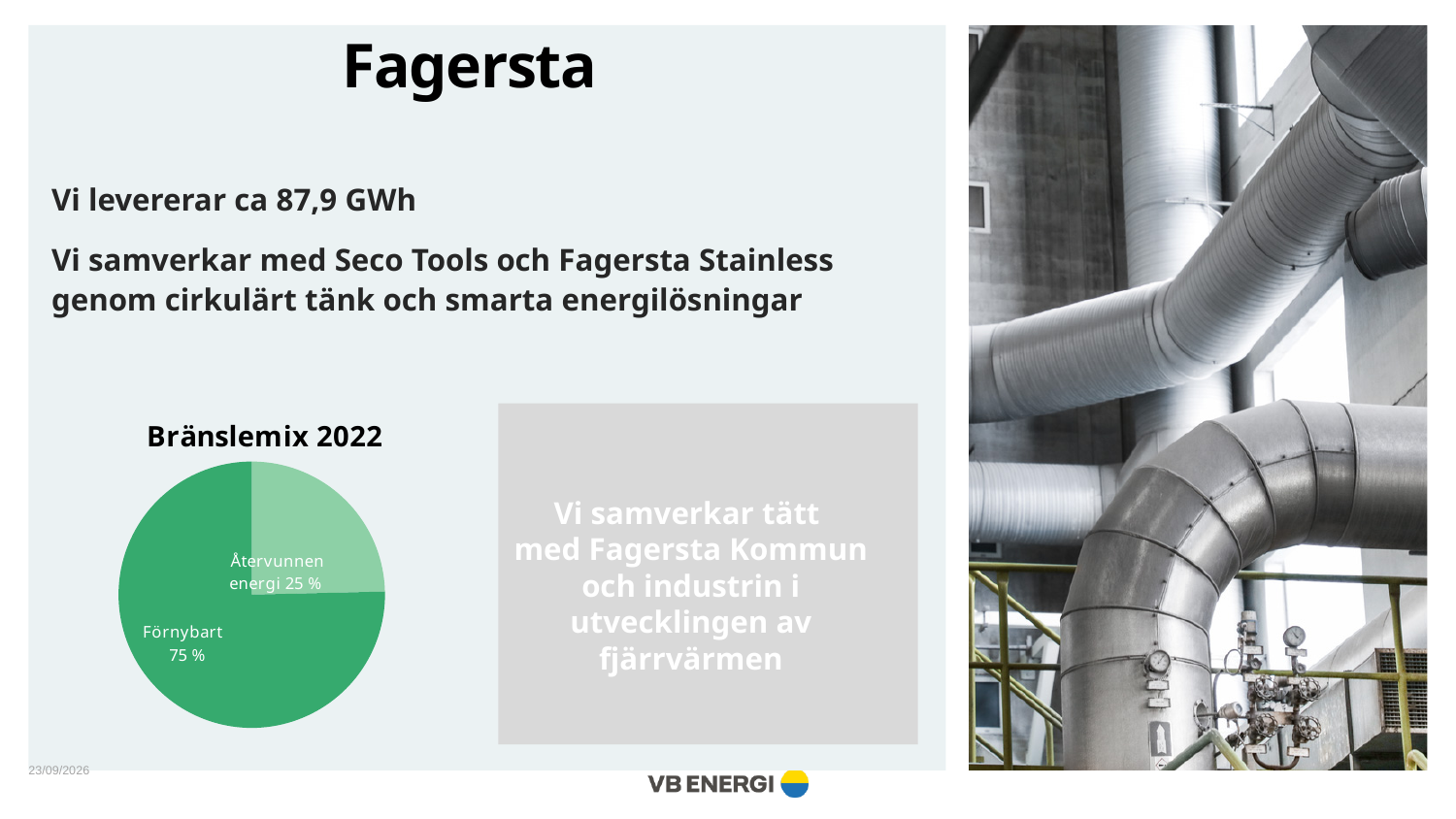
What is the title of the chart on the slide? Bränslemix 2022 What is the difference in percentage points between the Förnybart and Återvunnen energi slices? 50 percentage points Which slice of the pie chart is the smallest? Återvunnen energi How many slices does the pie chart have? 2 What kind of chart is shown under the title "Bränslemix 2022"? pie chart Which is larger in the pie chart, Förnybart or Återvunnen energi? Förnybart Which slice of the pie chart is shown in the lighter green colour? Återvunnen energi What share of the pie does Förnybart have? 75 % Which slice of the pie chart is the largest? Förnybart What share of the pie does Återvunnen energi have? 25 %